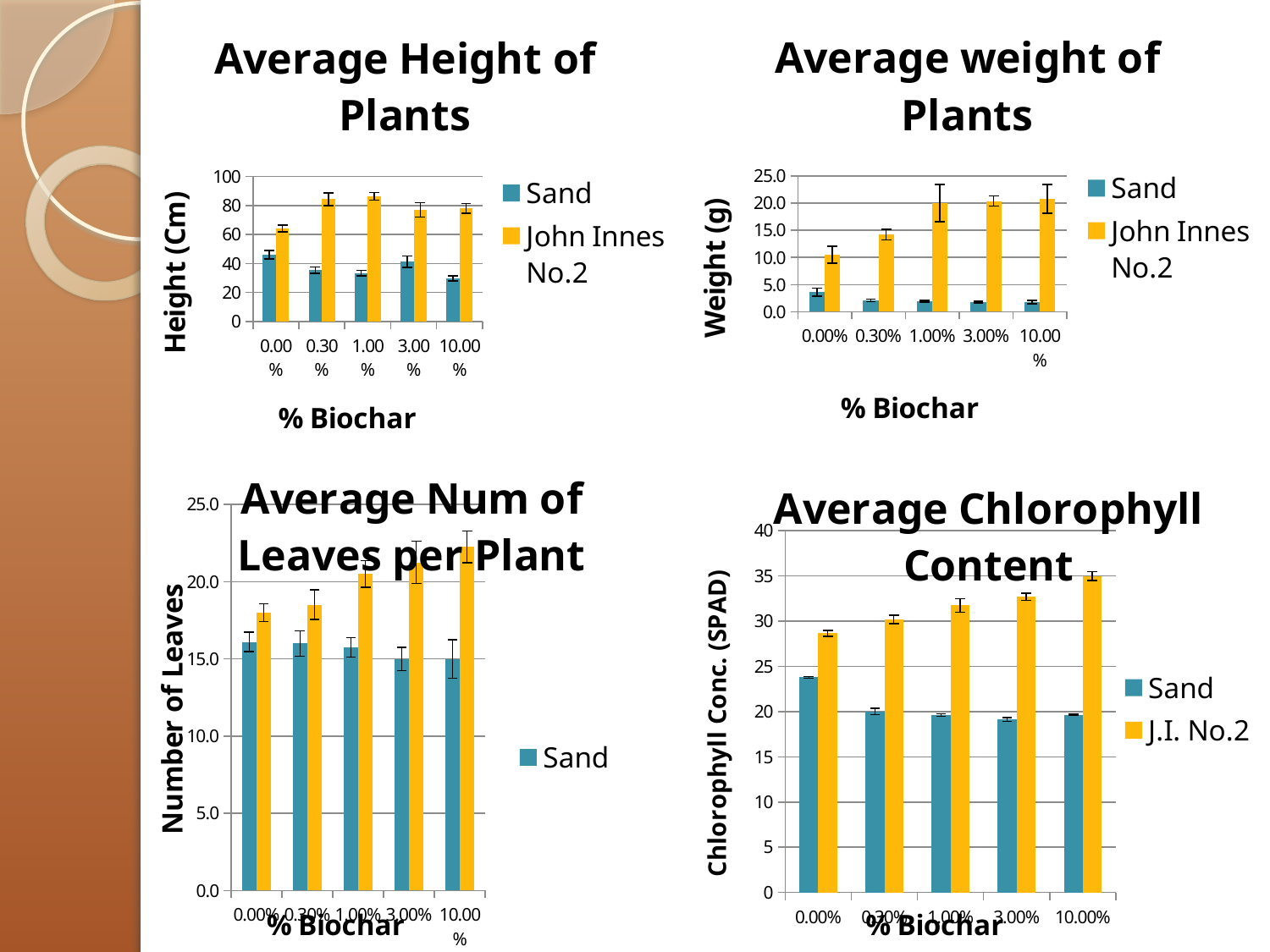
In the Average Chlorophyll Content chart, is the Sand value at 0.00% biochar greater or less than 20? greater In the Average Height of Plants chart, which biochar level has the lowest John Innes No.2 height? 0.00% In the Average Num of Leaves per Plant chart, is the yellow bar at 10.00% biochar greater or less than 20.0? greater In the Average weight of Plants chart, which biochar level has the lowest John Innes No.2 weight? 0.00% In the Average Chlorophyll Content chart, do the J.I. No.2 values rise or fall as the biochar percentage increases? rise In the Average Chlorophyll Content chart, which biochar level has the highest J.I. No.2 value? 10.00% In the Average weight of Plants chart, which is larger at 0.00% biochar, the Sand value or the John Innes No.2 value? John Innes No.2 In the Average Height of Plants chart, is the John Innes No.2 value at 1.00% biochar greater or less than 80? greater In the Average Num of Leaves per Plant chart, how many biochar levels are shown on the x axis? 5 What kind of chart is the Average Chlorophyll Content chart? bar chart